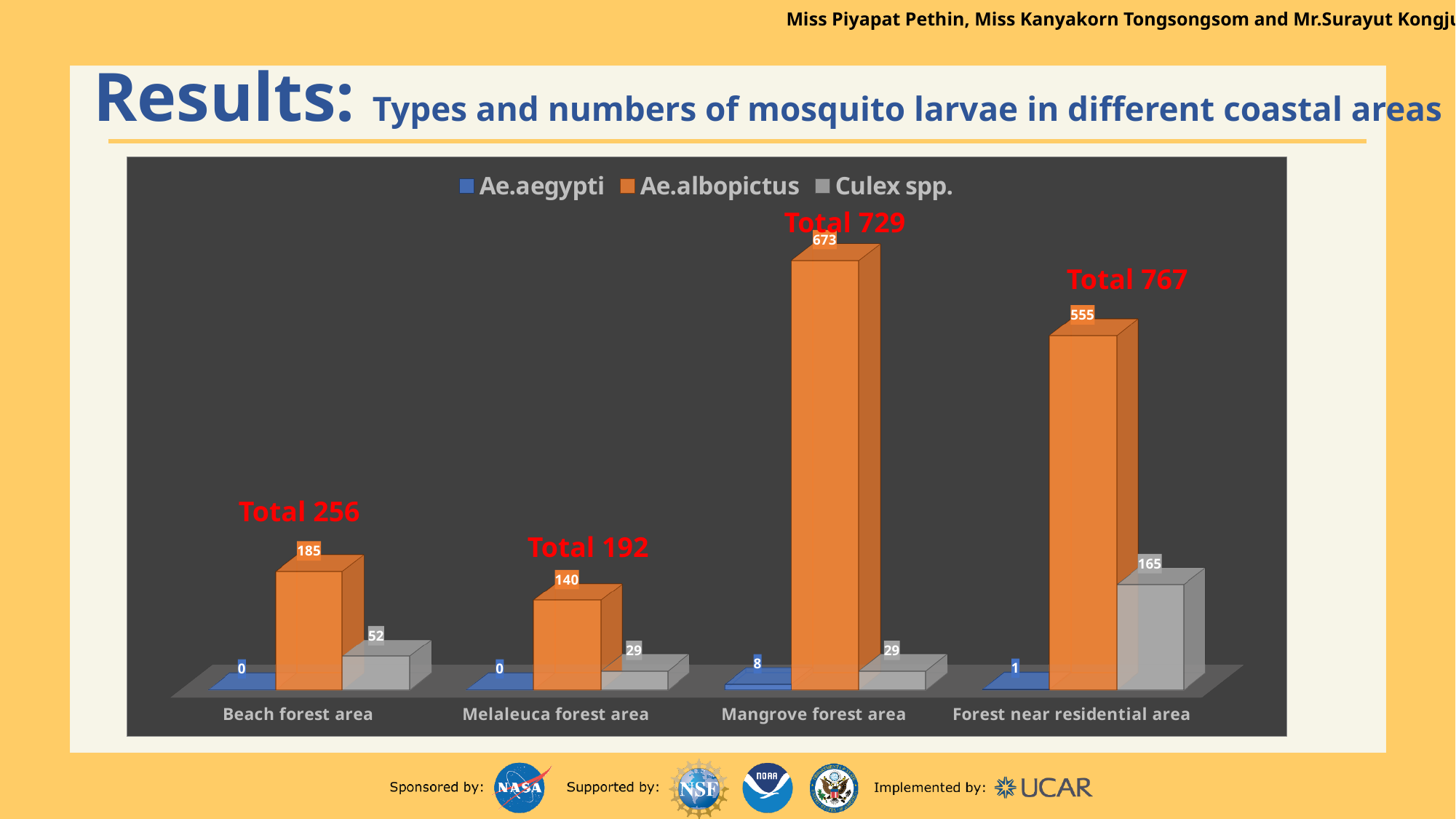
What is the value for Culex spp. in the Forest near residential area? 165 Which area has the highest value for Ae.albopictus? Mangrove forest area What is the difference between the Ae.albopictus values for the Mangrove forest area and the Forest near residential area? 118 How many coastal areas (categories) are shown on the x axis? 4 What is the value for Ae.albopictus in the Mangrove forest area? 673 Which area has the lowest value for Ae.albopictus? Melaleuca forest area What total is annotated above the Forest near residential area group? Total 767 Which series is shown in orange in the legend? Ae.albopictus What is the value for Ae.aegypti in the Mangrove forest area? 8 Which is larger: the Culex spp. value for the Beach forest area or for the Melaleuca forest area? Beach forest area How many series does the legend list? 3 What kind of chart is shown on the slide? bar chart